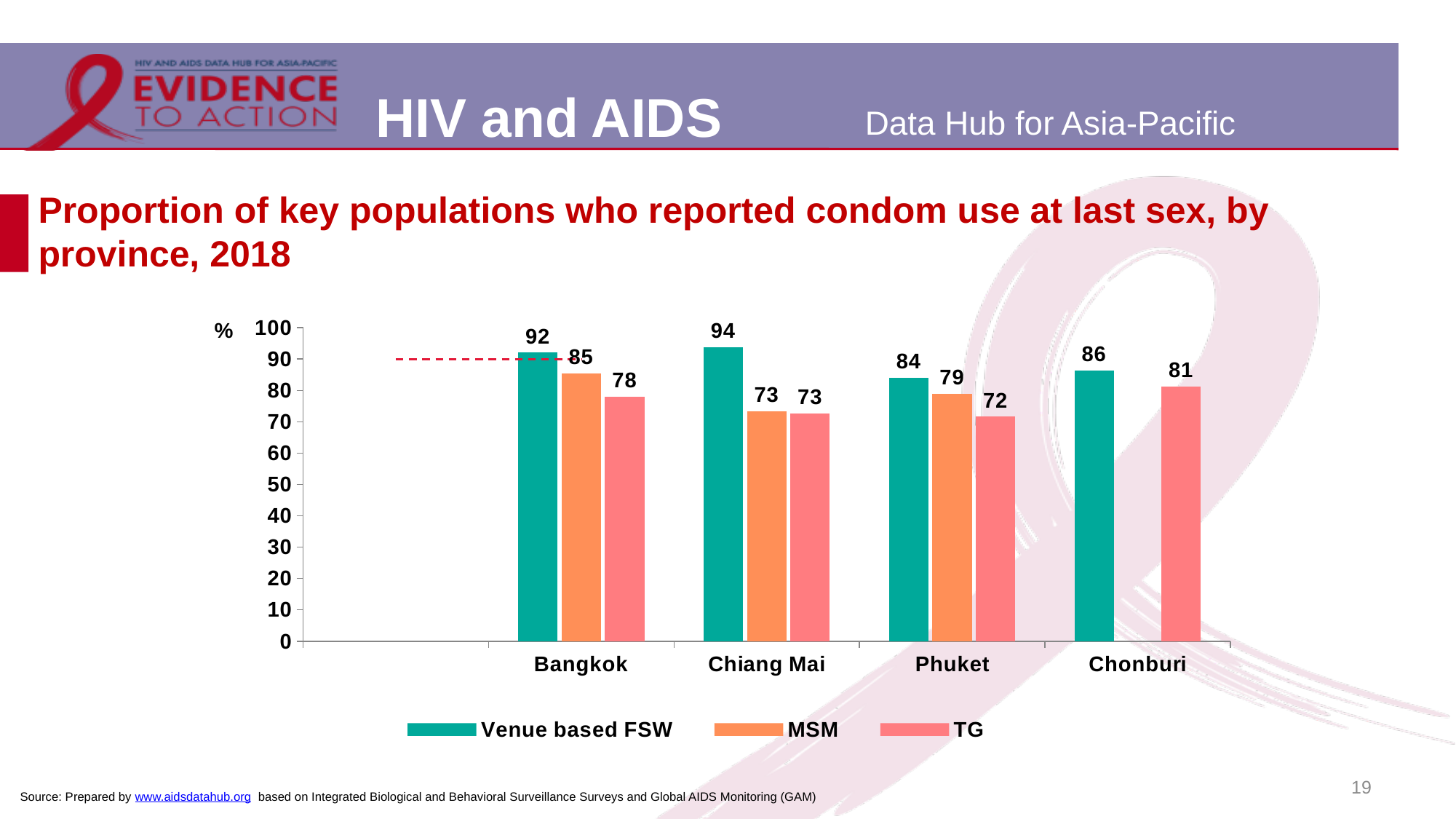
What is the value for Venue based FSW in Bangkok? 92 Which is larger in Bangkok, the MSM value or the TG value? MSM Which province has the lowest value for TG? Phuket How many provinces are shown on the x axis? 4 What kind of chart is shown on the slide? Bar chart What is the value for TG in Chonburi? 81 Is the value for Venue based FSW in Phuket greater or less than 90? less How many series does the legend list? 3 Which province has the highest value for Venue based FSW? Chiang Mai What is the difference between the Venue based FSW and MSM values in Chiang Mai? 21 What is the value for MSM in Phuket? 79 Which province has no MSM bar plotted? Chonburi